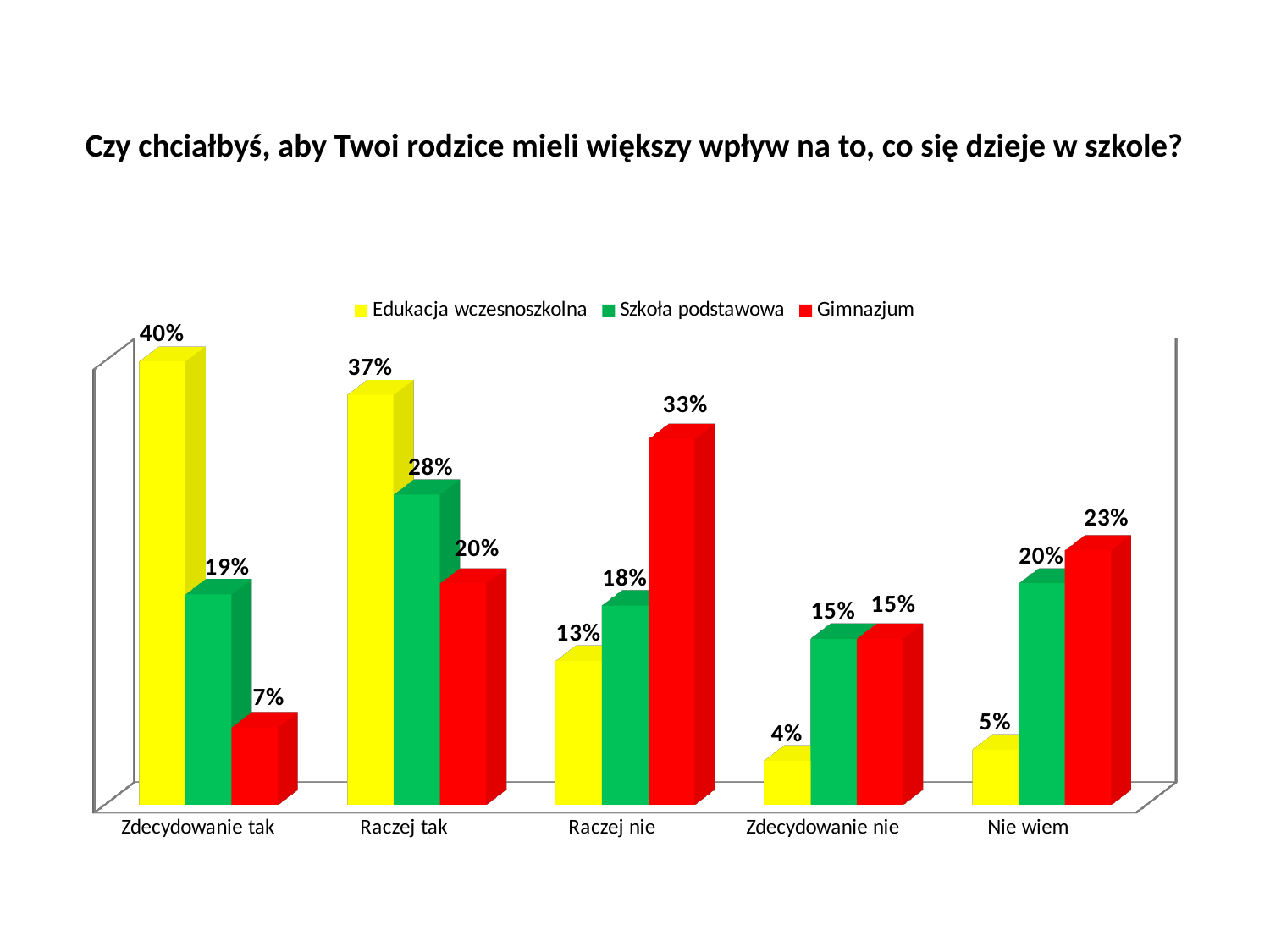
How many categories are shown on the x axis? 5 What is the value for Szkoła podstawowa in the Nie wiem category? 20% What is the difference between the Edukacja wczesnoszkolna and Gimnazjum values in the Zdecydowanie tak category? 33% What is the value for Edukacja wczesnoszkolna in the Zdecydowanie tak category? 40% What is the value for Gimnazjum in the Raczej nie category? 33% Which category has the lowest value for Edukacja wczesnoszkolna? Zdecydowanie nie Which is larger in the Raczej tak category: Szkoła podstawowa or Gimnazjum? Szkoła podstawowa What kind of chart is shown on the slide? Bar chart Which colour represents the Gimnazjum series? Red How many series does the legend list? 3 Which category has the highest value for Gimnazjum? Raczej nie Do the Edukacja wczesnoszkolna values rise or fall from Zdecydowanie tak to Zdecydowanie nie? Fall